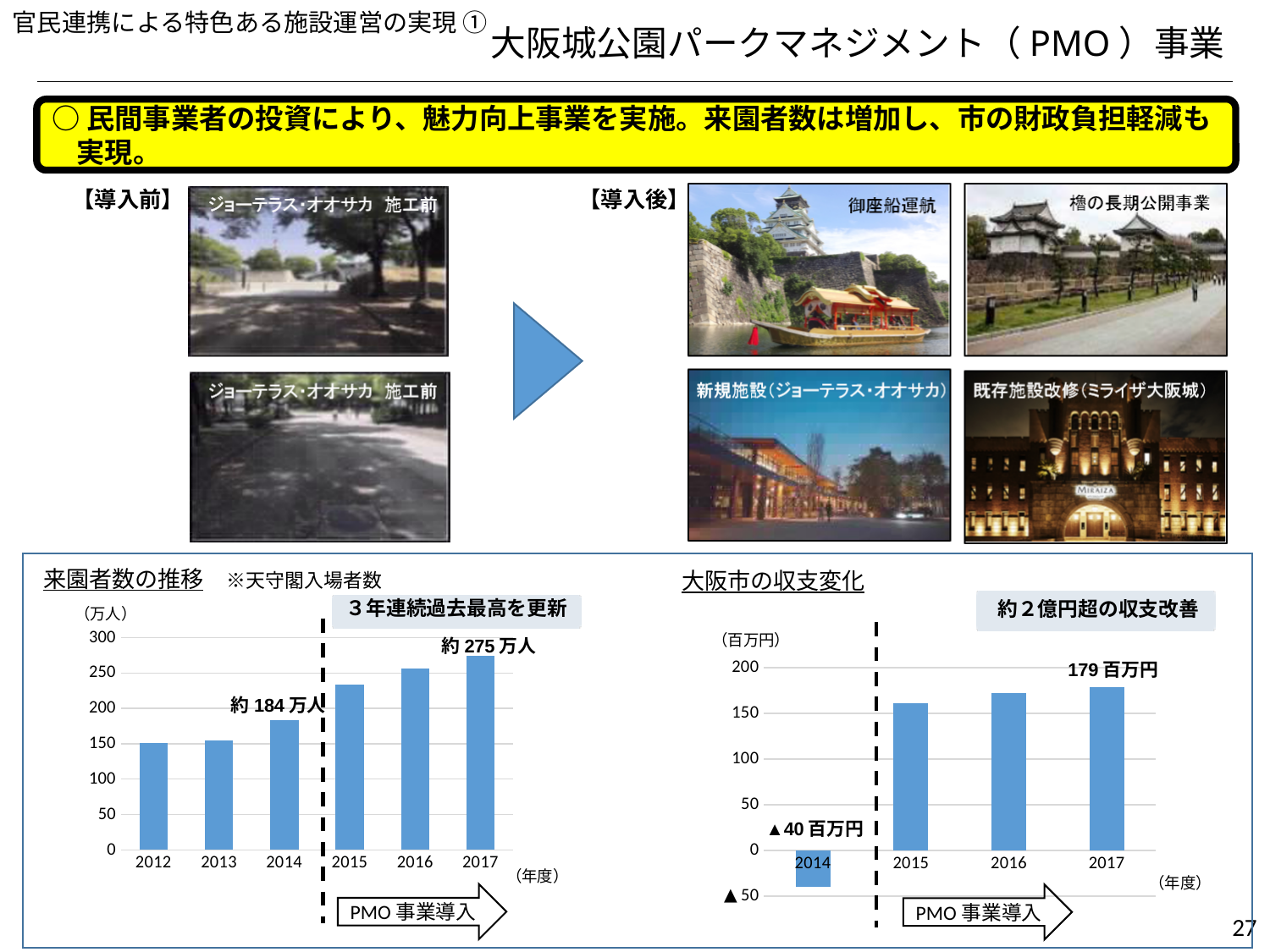
In the right chart (大阪市の収支変化), what is the labelled value for 2017? 179百万円 In the right chart (大阪市の収支変化), is the value for 2015 greater or less than 150? greater In the left chart (来園者数の推移), is the value for 2015 greater or less than 200? greater How many years are shown on the x axis of the left chart (来園者数の推移)? 6 In the left chart (来園者数の推移), what is the labelled value for 2017? 約275万人 In the left chart (来園者数の推移), do the values rise or fall from 2012 to 2017? rise What kind of chart is the right chart (大阪市の収支変化)? bar chart In the right chart (大阪市の収支変化), what is the difference between the 2017 value and the 2014 value? 219百万円 In the right chart (大阪市の収支変化), what is the labelled value for 2014? ▲40百万円 In the left chart (来園者数の推移), what is the labelled value for 2014? 約184万人 In the right chart (大阪市の収支変化), which year has the lowest value? 2014 In the left chart (来園者数の推移), which year has the highest value? 2017